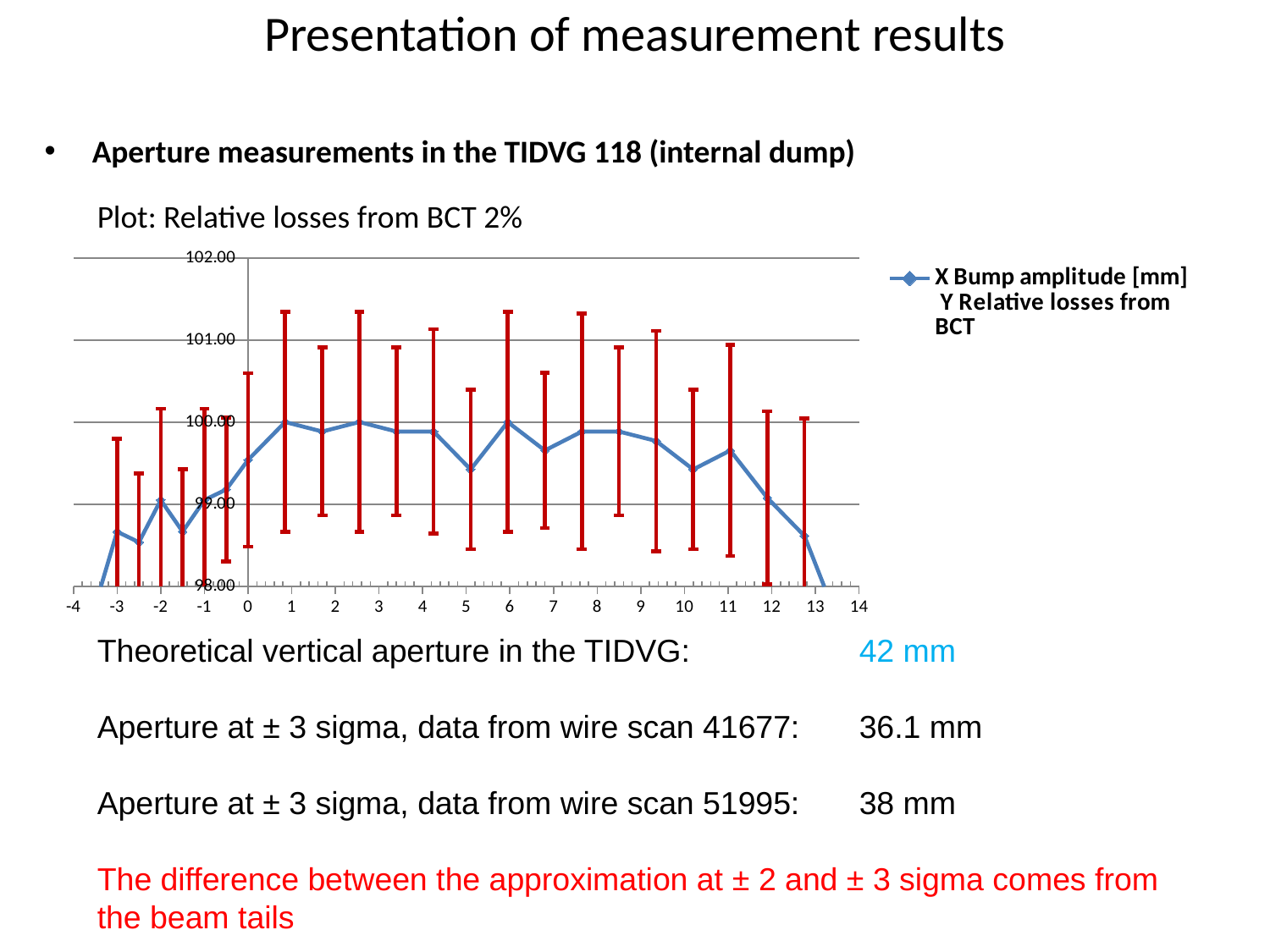
What kind of chart is shown on the slide? line chart Is the value at x = 5 greater or less than 99.00? greater Which has the larger value, the point at x = 1 or the point at x = 13? x = 1 What is the highest value shown on the chart's y axis? 102.00 Do the values rise or fall along the x axis between x = 11 and x = 13? fall Is the value at x = 13 greater or less than 99.00? less Is the value at x = 10 greater or less than 100.00? less How many series does the chart legend list? 1 What is the legend entry for the plotted series? X Bump amplitude [mm] Y Relative losses from BCT Which has the larger value, the point at x = 5 or the point at x = 6? x = 6